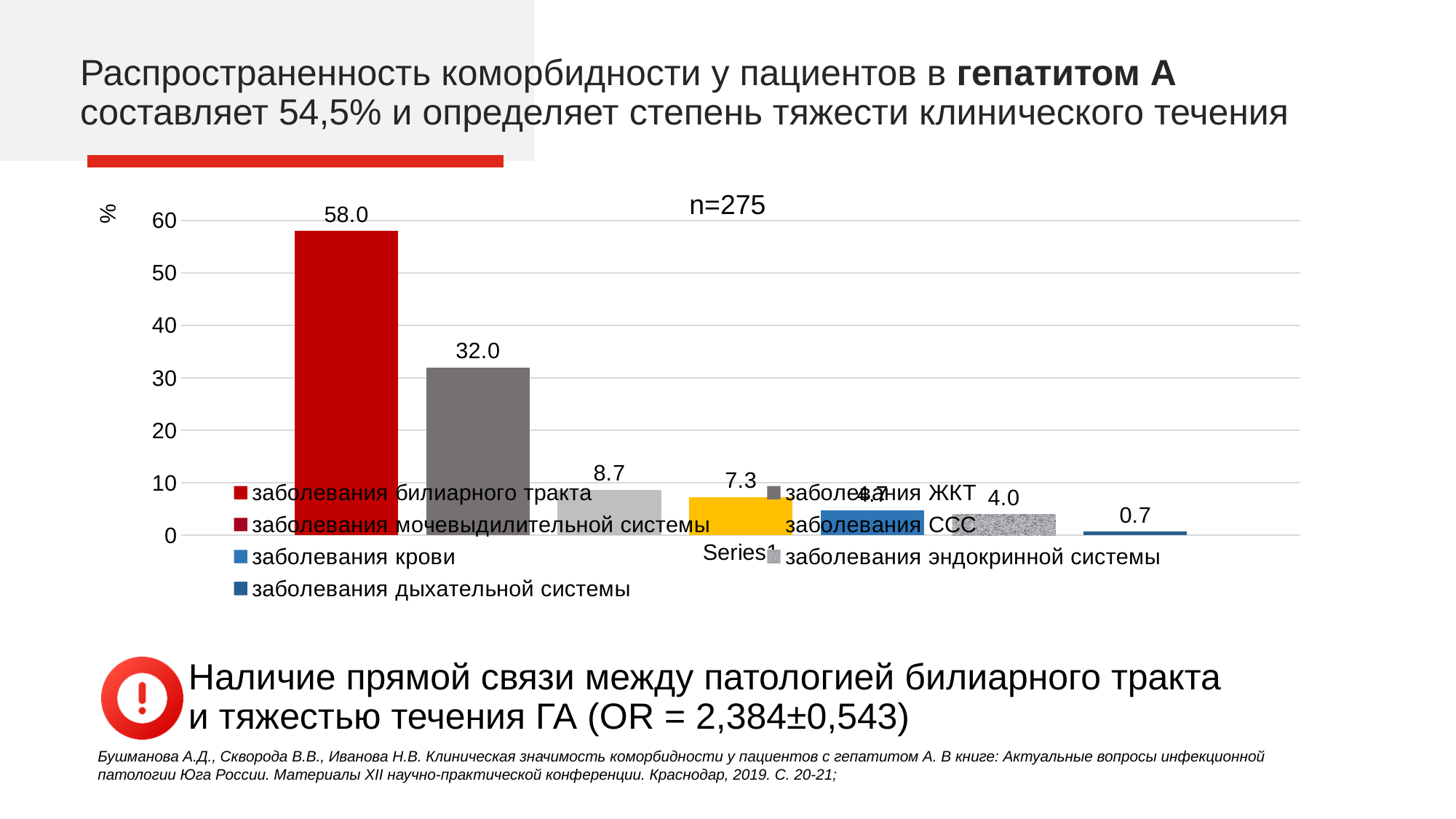
What is the lowest value shown in the chart? 0.7 What type of chart is shown on the slide? bar chart Which is larger: the value for заболевания билиарного тракта or the value for заболевания ЖКТ? заболевания билиарного тракта What is the difference between the values for заболевания билиарного тракта and заболевания ЖКТ? 26.0 How many entries does the chart legend list? 7 What is the highest value shown in the chart? 58.0 How many bars are plotted in the chart? 7 What unit is shown on the vertical axis of the chart? % What is the value of the red bar for заболевания билиарного тракта? 58.0 What is the value of the yellow bar? 7.3 What is the value of the dark grey bar for заболевания ЖКТ? 32.0 What sample size (n) is stated above the chart? n=275